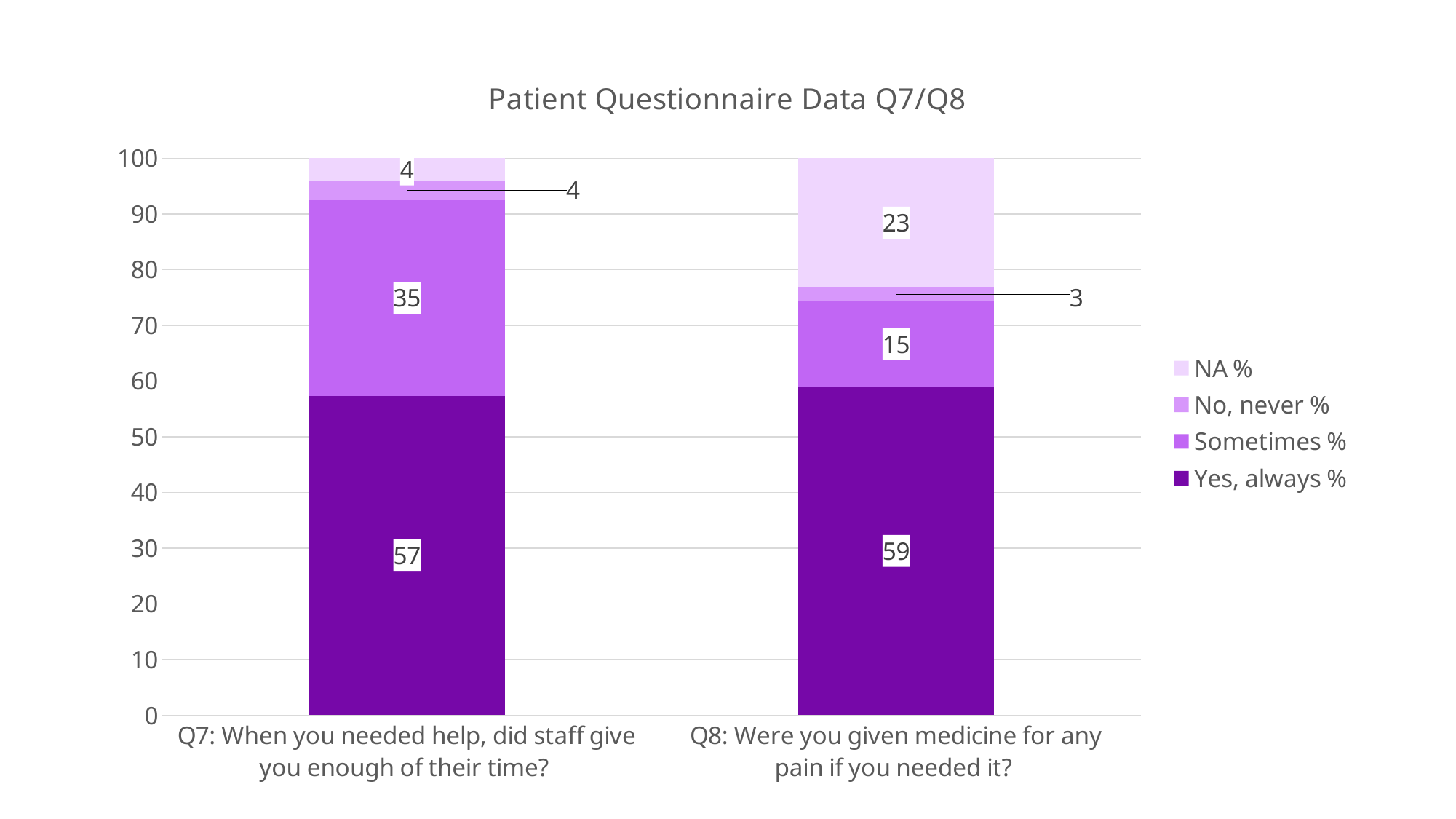
Which question has the lower 'Sometimes %' value? Q8: Were you given medicine for any pain if you needed it? What is the 'NA %' value for Q8: Were you given medicine for any pain if you needed it? 23 What is the 'No, never %' value for Q8: Were you given medicine for any pain if you needed it? 3 What is the 'Yes, always %' value for Q7: When you needed help, did staff give you enough of their time? 57 Is the 'NA %' value larger for Q7 or for Q8? Q8 How many series does the legend list? 4 What is the difference between the 'Sometimes %' values for Q7 and Q8? 20 What kind of chart is shown on the slide? Stacked bar chart What is the 'Sometimes %' value for Q8: Were you given medicine for any pain if you needed it? 15 What is the title of the chart? Patient Questionnaire Data Q7/Q8 How many questions (categories) are shown on the x axis? 2 Which question has the higher 'Yes, always %' value? Q8: Were you given medicine for any pain if you needed it?